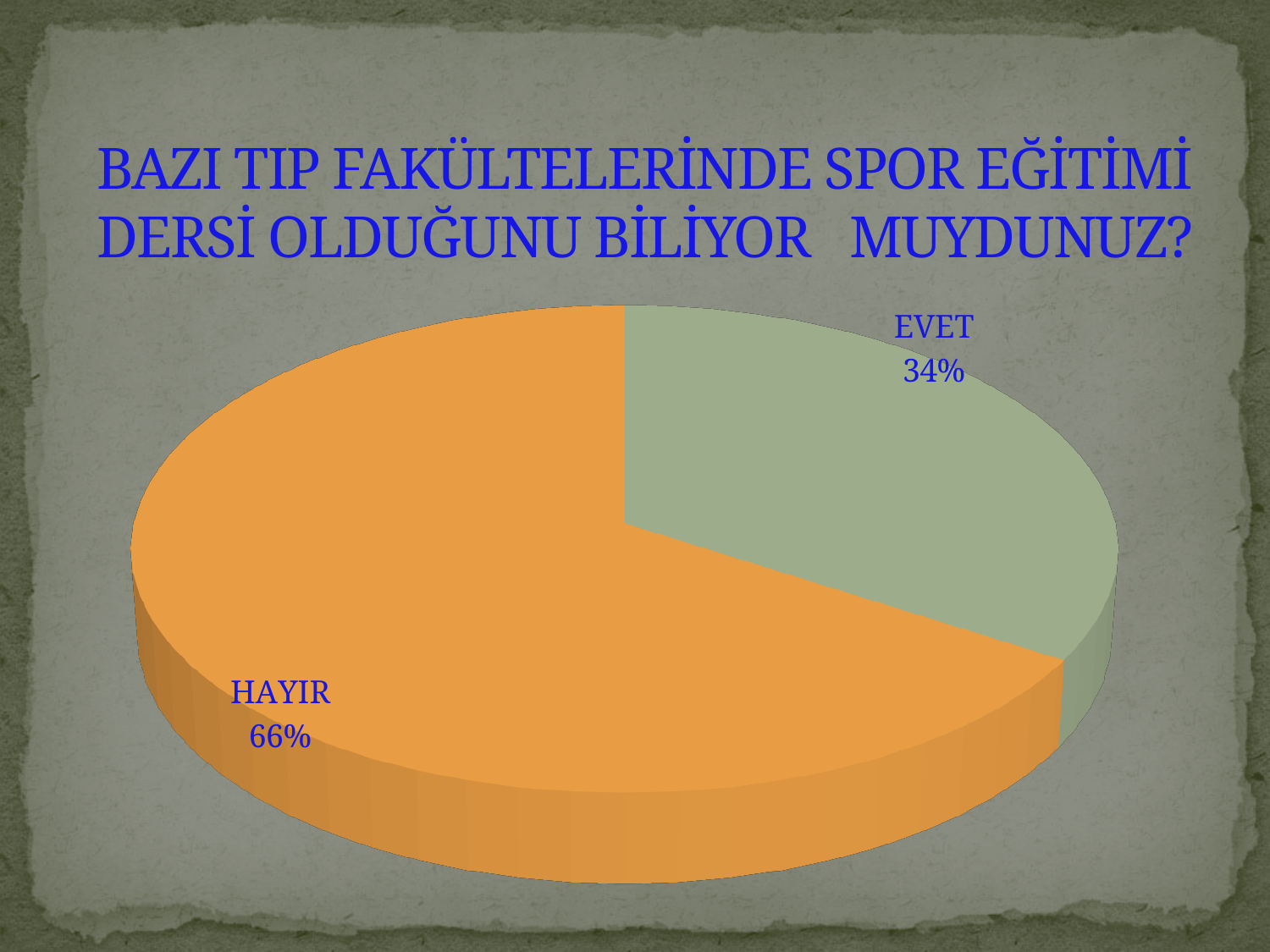
What share of the pie does HAYIR represent? 66% Which is larger, EVET or HAYIR? HAYIR What is the difference in percentage points between HAYIR and EVET? 32 Which slice is the smallest? EVET What share of the pie does EVET represent? 34% What colour is the EVET slice? green Is the value for EVET greater or less than 50%? less Which slice is the largest? HAYIR What kind of chart is shown on the slide? pie chart What colour is the HAYIR slice? orange How many slices does the pie chart have? 2